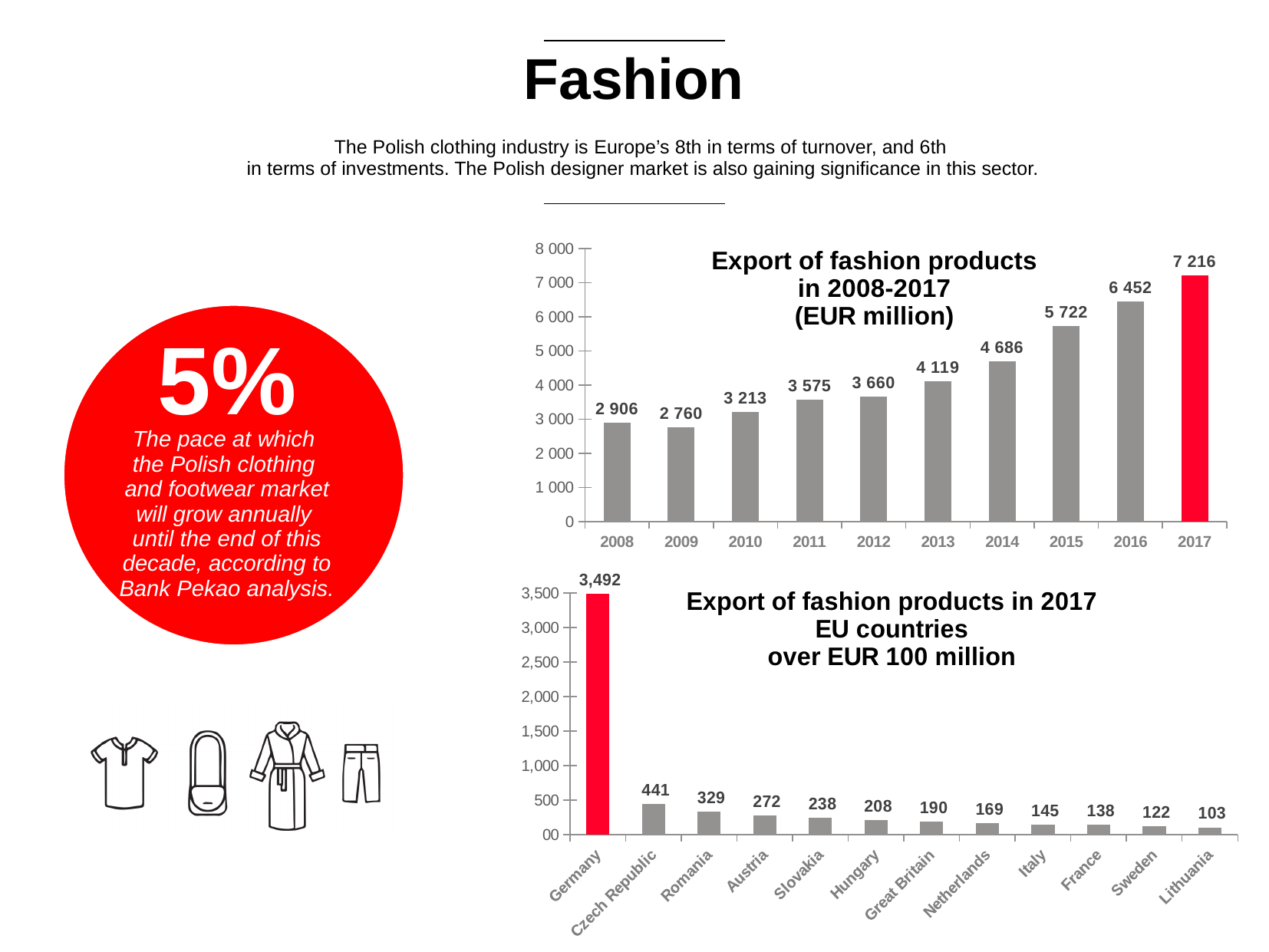
In the 'Export of fashion products in 2017' chart, how many countries are shown? 12 In the 'Export of fashion products in 2008-2017' chart, what is the value for 2017? 7 216 In the 'Export of fashion products in 2017' chart, what is the difference between the Czech Republic and Hungary values? 233 In the 'Export of fashion products in 2008-2017' chart, do the values generally rise or fall from 2009 to 2017? rise What type of chart is the 'Export of fashion products in 2017' chart? bar chart In the 'Export of fashion products in 2017' chart, which is larger, the value for Romania or the value for Austria? Romania In the 'Export of fashion products in 2017' chart, what is the value for Germany? 3,492 In the 'Export of fashion products in 2008-2017' chart, what is the value for 2013? 4 119 In the 'Export of fashion products in 2008-2017' chart, how many years are shown? 10 In the 'Export of fashion products in 2008-2017' chart, which year has the lowest value? 2009 In the 'Export of fashion products in 2017' chart, which country has the lowest value? Lithuania In the 'Export of fashion products in 2008-2017' chart, what is the difference between the 2017 and 2008 values? 4 310